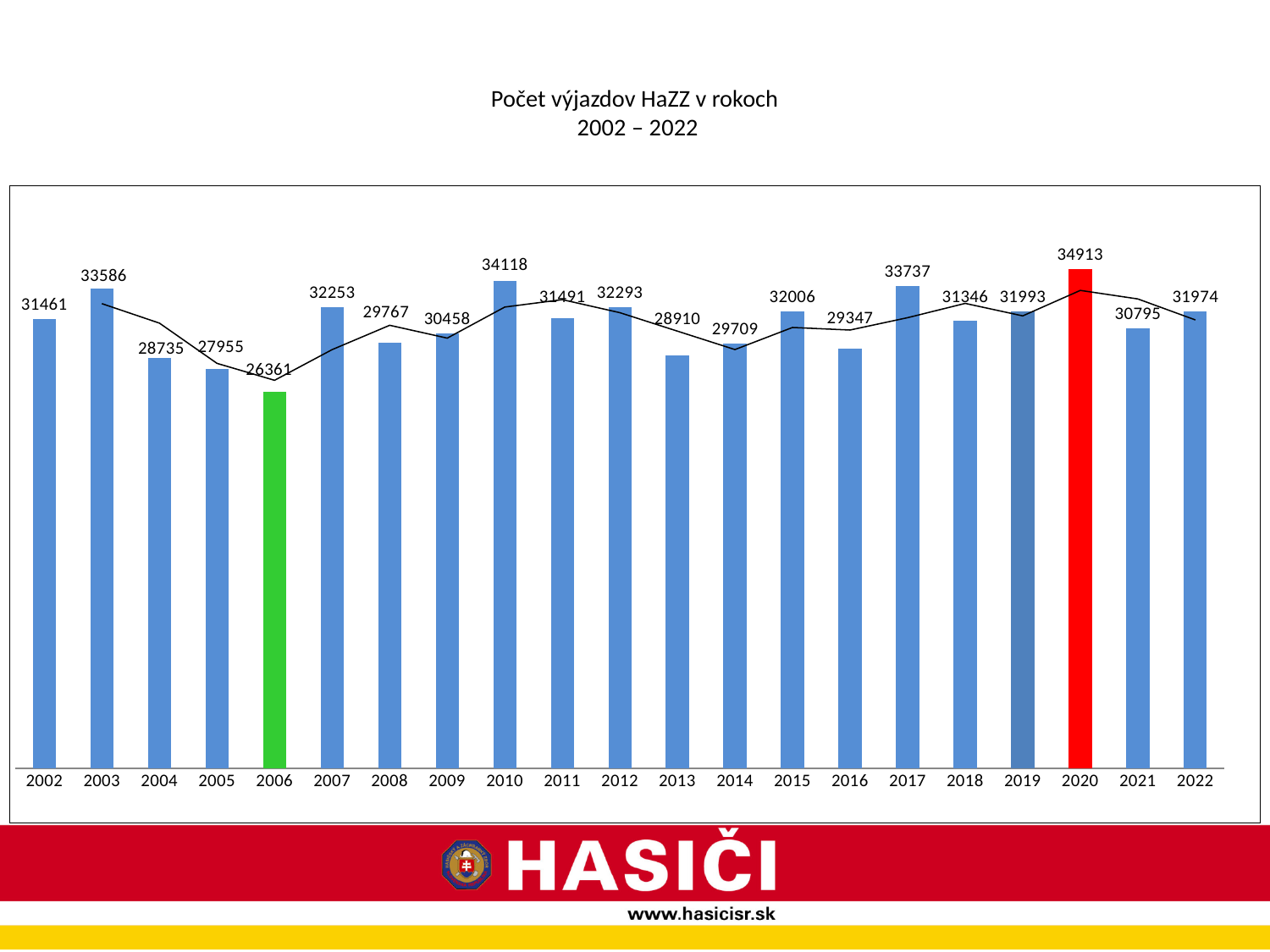
What kind of chart is this? bar chart Do the values rise or fall from 2002 to 2006? fall What is the difference between the values for 2003 and 2002? 2125 What colour is the bar for 2020? red Which is larger, the value for 2010 or the value for 2017? 2010 What is the value for 2013? 28910 Which year has the lowest value? 2006 How many years are shown on the x axis? 21 What is the difference between the values for 2020 and 2006? 8552 What is the value for 2006? 26361 What is the value for 2020? 34913 Which year has the highest value? 2020